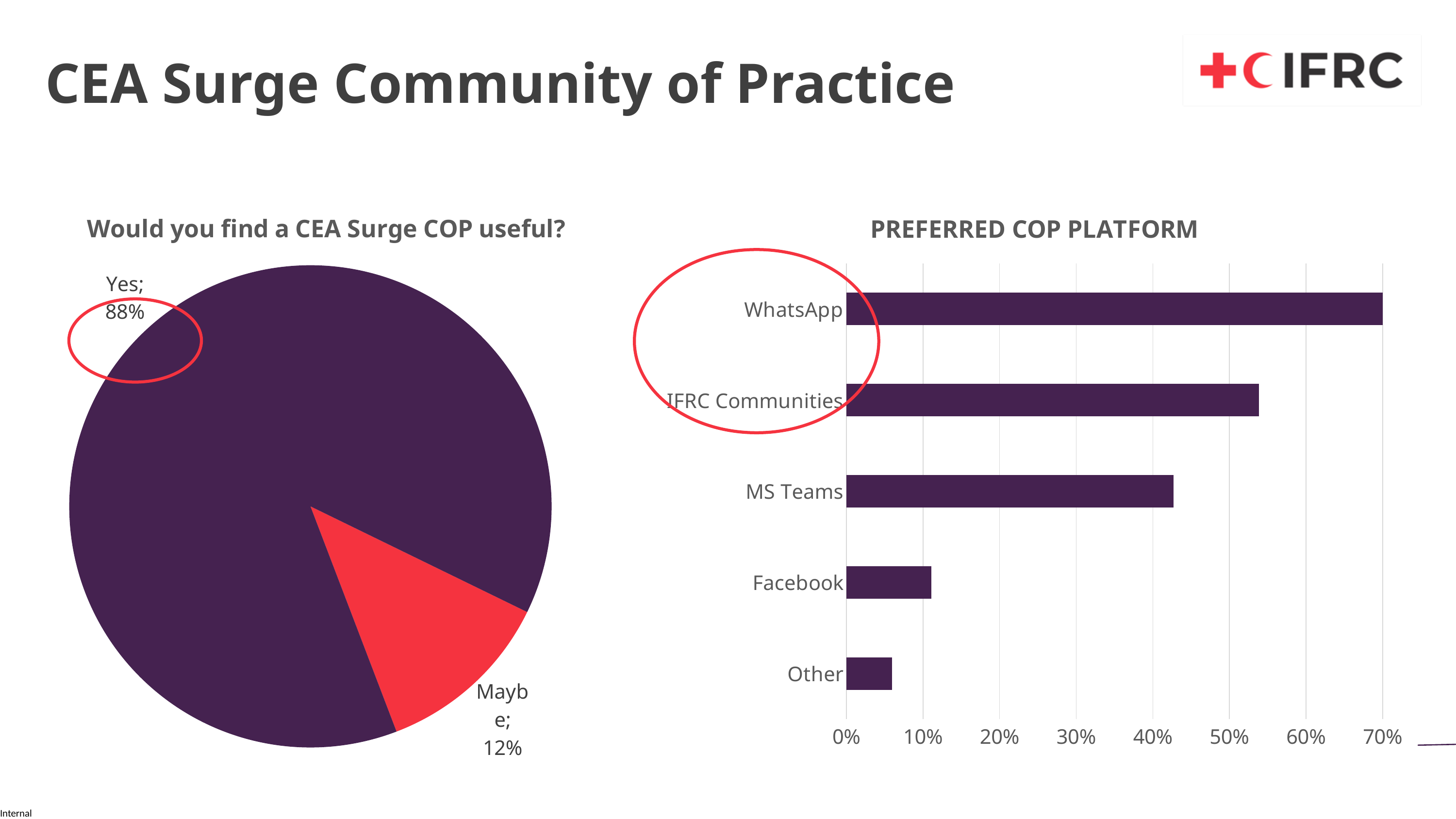
In the pie chart 'Would you find a CEA Surge COP useful?', what share of respondents answered Maybe? 12% In the 'PREFERRED COP PLATFORM' chart, which platform has the lowest value? Other How many slices does the pie chart 'Would you find a CEA Surge COP useful?' have? 2 What kind of chart is 'PREFERRED COP PLATFORM'? bar chart In the 'PREFERRED COP PLATFORM' chart, which platform has the highest value? WhatsApp In the 'PREFERRED COP PLATFORM' chart, which has a larger value, IFRC Communities or MS Teams? IFRC Communities In the 'PREFERRED COP PLATFORM' chart, is the value for Facebook greater or less than 20%? less In the 'PREFERRED COP PLATFORM' chart, how many platforms are listed? 5 In the pie chart 'Would you find a CEA Surge COP useful?', how many percentage points larger is the Yes slice than the Maybe slice? 76 In the pie chart 'Would you find a CEA Surge COP useful?', what share of respondents answered Yes? 88% In the pie chart 'Would you find a CEA Surge COP useful?', which response has the largest slice? Yes In the 'PREFERRED COP PLATFORM' chart, is the value for WhatsApp greater or less than 60%? greater